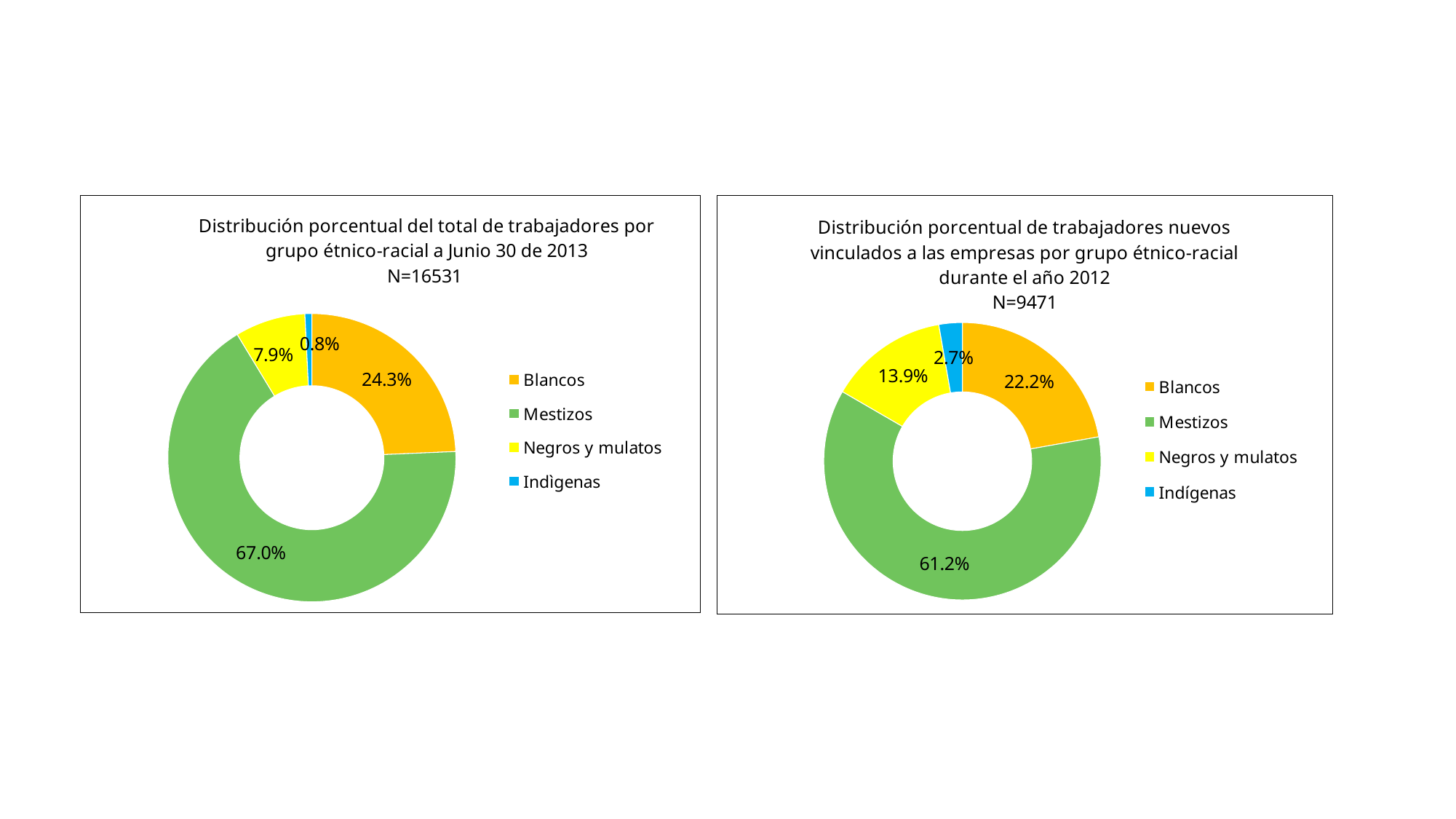
In the right chart (trabajadores nuevos durante el año 2012), what percentage is shown for Blancos? 22.2% What is the N value stated in the title of the right chart (trabajadores nuevos durante el año 2012)? N=9471 In the right chart (trabajadores nuevos durante el año 2012), what percentage is shown for Negros y mulatos? 13.9% What type of chart is the right chart (trabajadores nuevos durante el año 2012)? Doughnut (pie) chart In the left chart (total de trabajadores a Junio 30 de 2013), what is the difference in percentage points between Blancos and Negros y mulatos? 16.4 In the right chart (trabajadores nuevos durante el año 2012), which group has the smallest share? Indígenas In the left chart (total de trabajadores a Junio 30 de 2013), what percentage is shown for Mestizos? 67.0% In the left chart (total de trabajadores a Junio 30 de 2013), which group has the largest share? Mestizos How many groups are shown in the left chart (total de trabajadores a Junio 30 de 2013)? 4 In the left chart (total de trabajadores a Junio 30 de 2013), what percentage is shown for Indígenas? 0.8% Is the share of Indígenas larger in the left chart (2013 total) or in the right chart (nuevos 2012)? Right chart (nuevos 2012) In the right chart (trabajadores nuevos durante el año 2012), what is the difference in percentage points between Mestizos and Blancos? 39.0